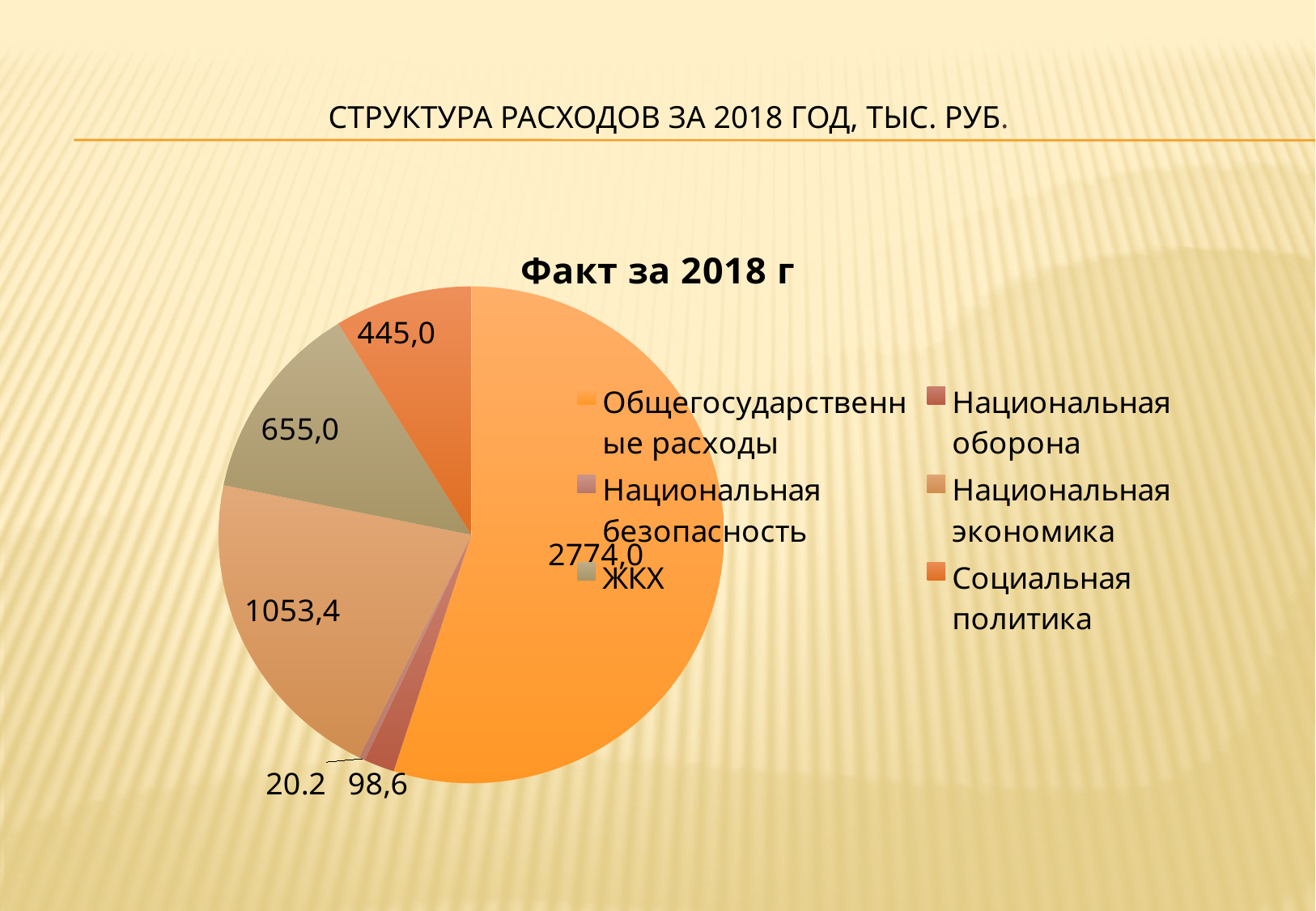
What is the value for Национальная оборона? 98,6 What is the value for ЖКХ? 655,0 Which is larger, the value for ЖКХ or the value for Социальная политика? ЖКХ What is the title of the chart? Факт за 2018 г What is the value for Общегосударственные расходы? 2774,0 What is the value for Национальная экономика? 1053,4 Which category has the smallest slice of the pie? Национальная безопасность How many categories does the pie chart have? 6 What is the difference between the values for Общегосударственные расходы and Национальная экономика? 1720,6 What is the value for Социальная политика? 445,0 Which category has the largest slice of the pie? Общегосударственные расходы What type of chart is shown on the slide? Pie chart